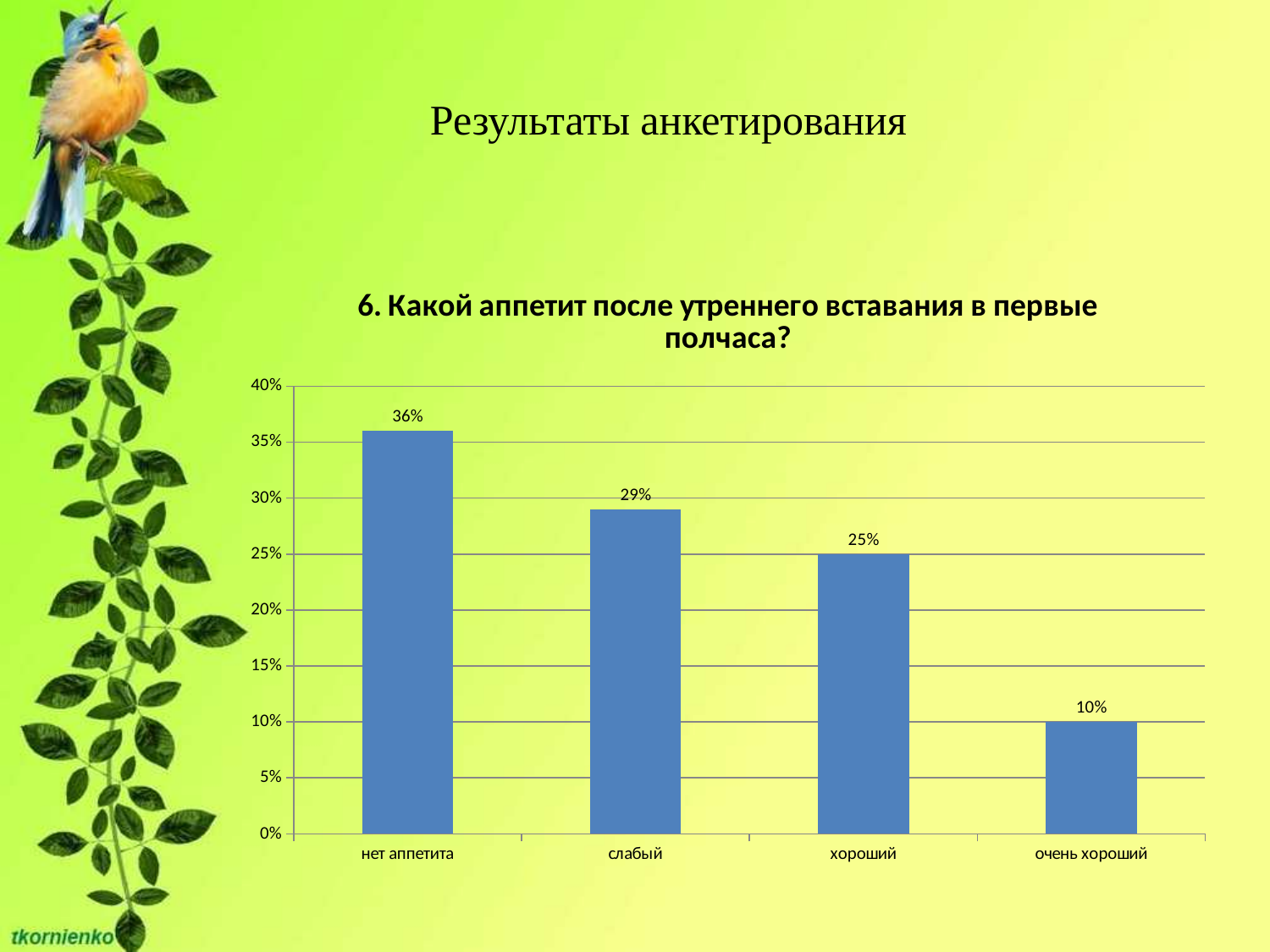
Which is larger, the value for "слабый" or the value for "хороший"? слабый How many categories are shown on the x axis? 4 What is the difference between the values for "слабый" and "хороший"? 4% What is the difference between the values for "нет аппетита" and "очень хороший"? 26% What kind of chart is shown on the slide? bar chart Which category has the highest value? нет аппетита Which category has the lowest value? очень хороший What is the value for "слабый"? 29% What is the value for "очень хороший"? 10% What is the value for "нет аппетита"? 36% Do the values rise or fall from left to right along the x axis? fall What is the value for "хороший"? 25%